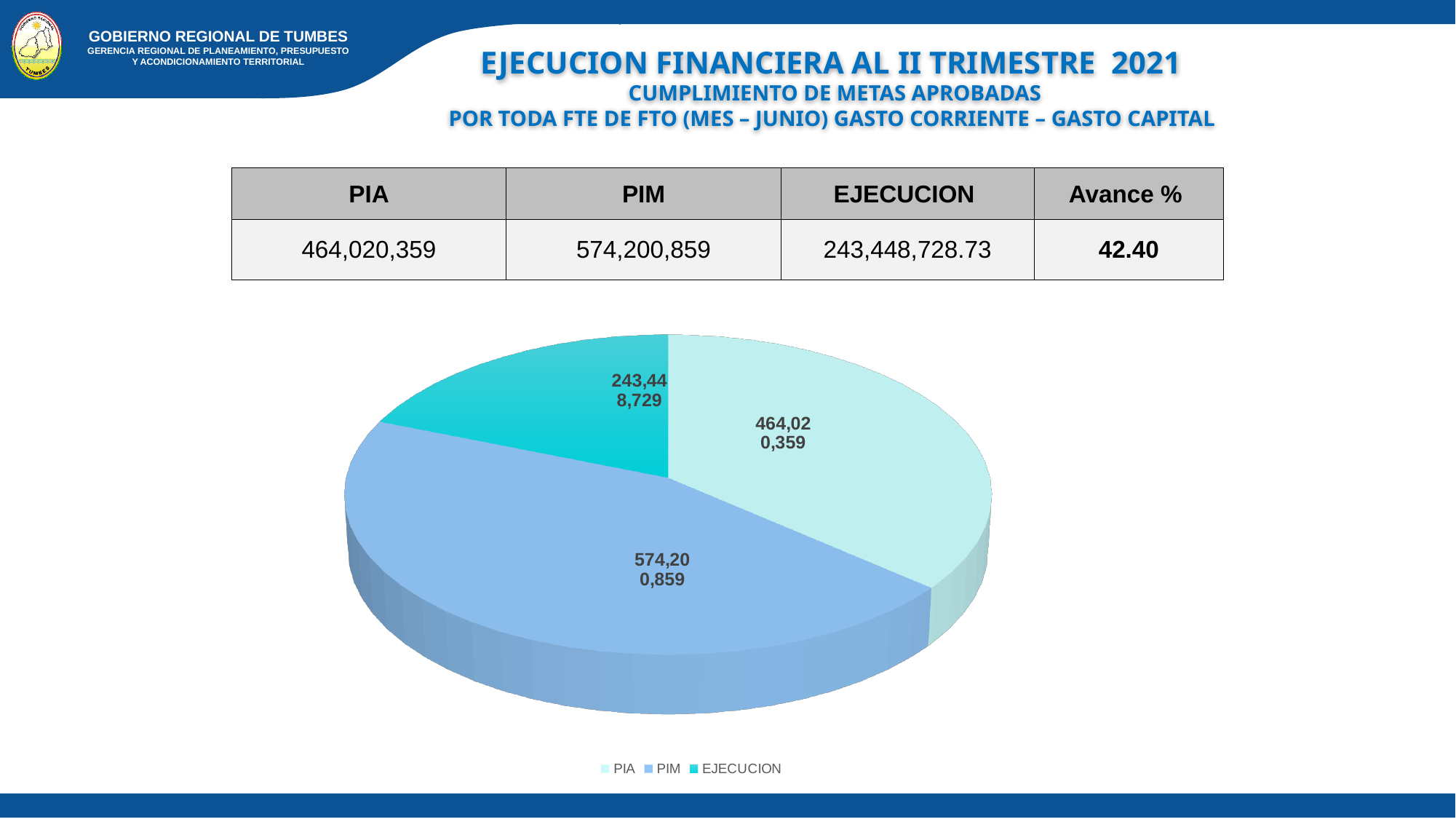
How many entries does the legend of the pie chart list? 3 Which slice of the pie chart has the largest value? PIM Which legend entry of the pie chart is shown in the darkest teal colour? EJECUCION What is the difference between the PIM and PIA values in the pie chart? 110,180,500 Which is larger in the pie chart, PIA or EJECUCION? PIA Which slice of the pie chart has the smallest value? EJECUCION What is the difference between the PIA and EJECUCION values in the pie chart? 220,571,630 What value is shown for the PIA slice of the pie chart? 464,020,359 What kind of chart is shown on the slide? pie chart What value is shown for the PIM slice of the pie chart? 574,200,859 What value is shown for the EJECUCION slice of the pie chart? 243,448,729 How many slices does the pie chart have? 3